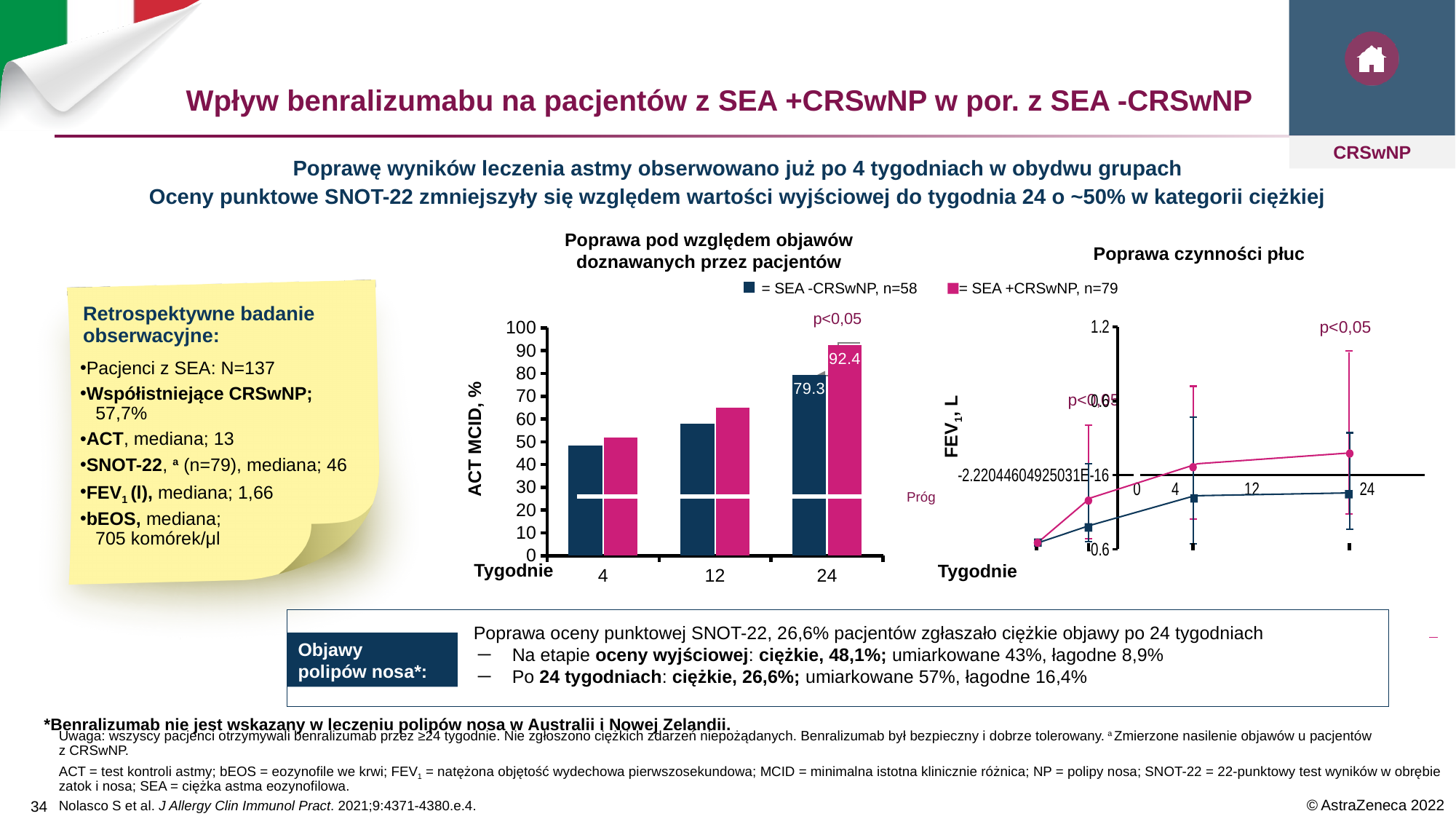
How many series does the legend list for the bar chart 'Poprawa pod względem objawów doznawanych przez pacjentów'? 2 What kind of chart is 'Poprawa czynności płuc'? line chart In the bar chart 'Poprawa pod względem objawów doznawanych przez pacjentów', what is the difference between the SEA +CRSwNP and SEA -CRSwNP values at week 24? 13.1 In the bar chart 'Poprawa pod względem objawów doznawanych przez pacjentów', which group has the larger value at week 24? SEA +CRSwNP In the bar chart 'Poprawa pod względem objawów doznawanych przez pacjentów', is the value for SEA +CRSwNP at week 12 greater or less than 50? greater In the bar chart 'Poprawa pod względem objawów doznawanych przez pacjentów', is the value for SEA -CRSwNP at week 4 greater or less than 60? less In the bar chart 'Poprawa pod względem objawów doznawanych przez pacjentów', do the values for SEA +CRSwNP rise or fall from week 4 to week 24? rise In the bar chart 'Poprawa pod względem objawów doznawanych przez pacjentów', which bar is the highest? SEA +CRSwNP at week 24 In the bar chart 'Poprawa pod względem objawów doznawanych przez pacjentów', what is the value for SEA +CRSwNP at week 24? 92.4 How many time points (categories) are shown on the x axis of the bar chart 'Poprawa pod względem objawów doznawanych przez pacjentów'? 3 In the bar chart 'Poprawa pod względem objawów doznawanych przez pacjentów', what is the value for SEA -CRSwNP at week 24? 79.3 What kind of chart is 'Poprawa pod względem objawów doznawanych przez pacjentów'? bar chart